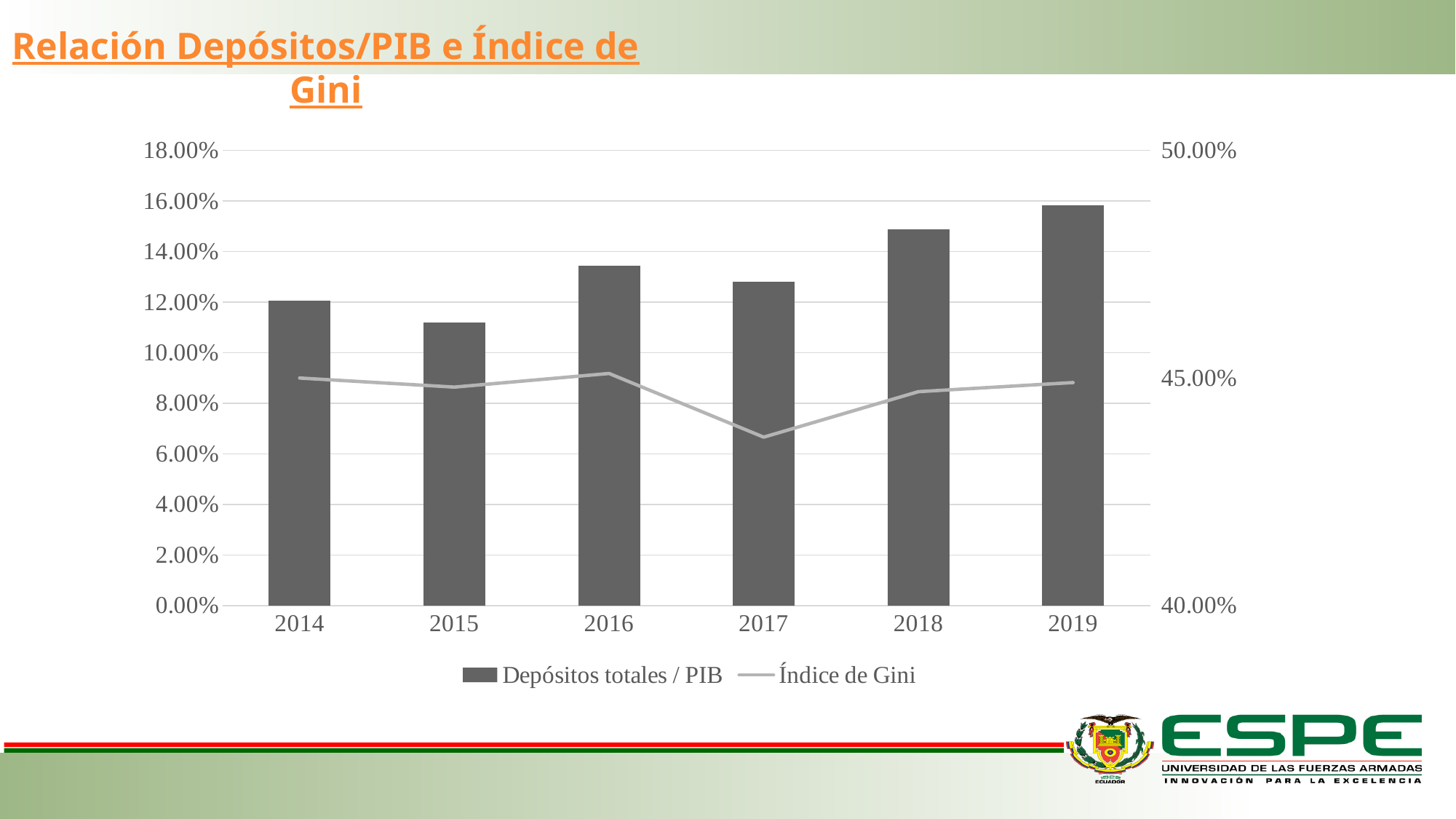
How many years are shown on the x axis of the chart? 6 Does the Depósitos totales / PIB value rise or fall from 2017 to 2019? rise Which year has the lowest value for Depósitos totales / PIB? 2015 How many series does the legend list? 2 In which year does the Índice de Gini line reach its lowest point? 2017 Which year has the highest value for Depósitos totales / PIB? 2019 Is the value for Depósitos totales / PIB in 2015 greater or less than 12.00%? less Is the Índice de Gini value in 2017 greater or less than 45.00%? less Which is larger, the Depósitos totales / PIB value for 2016 or for 2017? 2016 What kind of chart is shown on the slide? Combined bar and line chart What is the title of the chart on the slide? Relación Depósitos/PIB e Índice de Gini Is the value for Depósitos totales / PIB in 2019 greater or less than 14.00%? greater